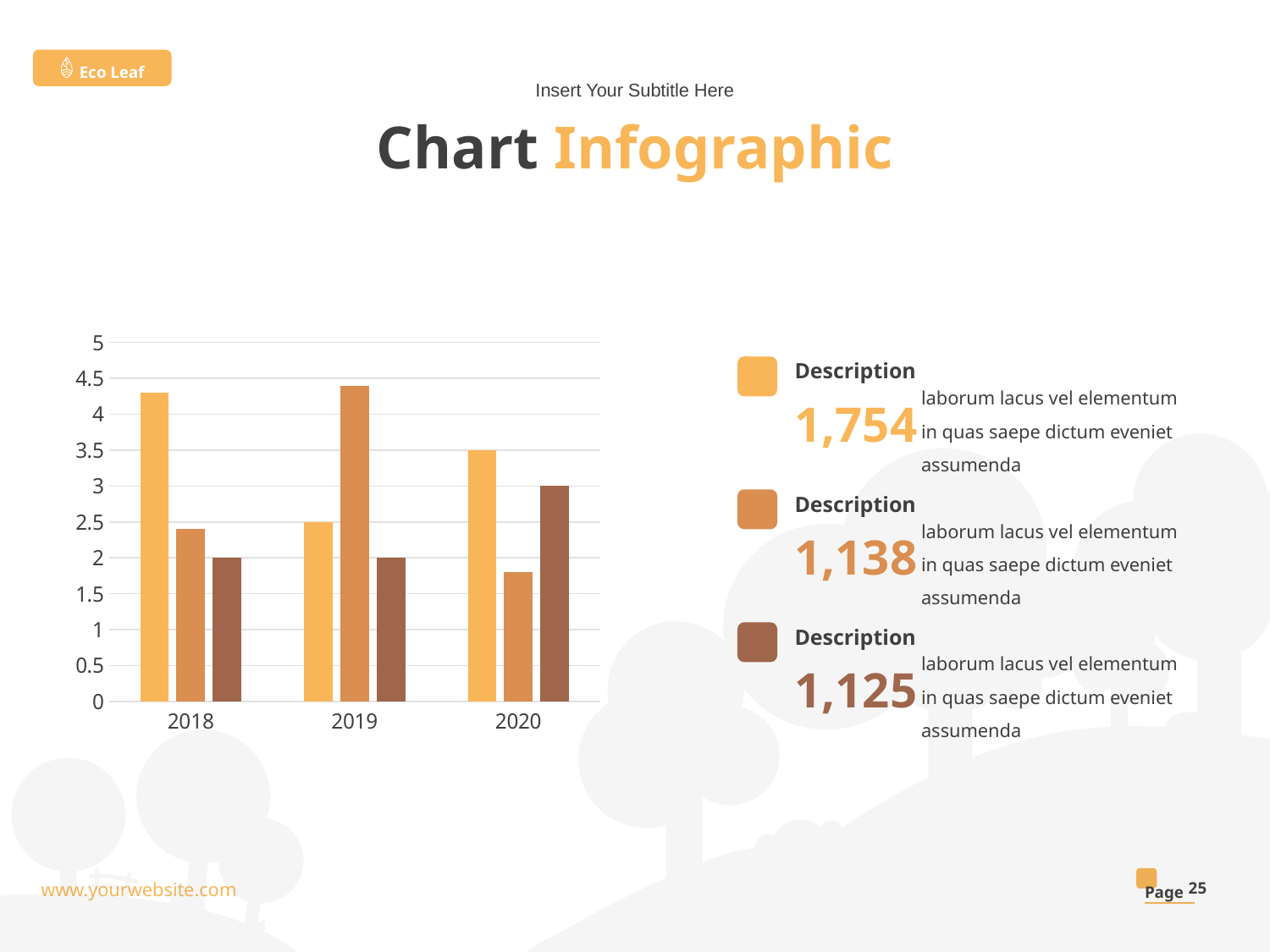
How many categories are shown on the x axis of the chart? 3 Which bar is the shortest for 2020: the light orange, medium orange or brown bar? medium orange What kind of chart is shown on the slide? bar chart Is the value of the medium orange bar for 2019 greater or less than 4? greater Which bar is the tallest for 2019: the light orange, medium orange or brown bar? medium orange Is the value of the light orange bar for 2020 greater or less than 3? greater Is the value of the medium orange bar for 2020 greater or less than 2? less What is the highest value shown on the y axis of the chart? 5 For 2018, which is larger: the light orange bar or the brown bar? light orange How many bars are plotted for each year in the chart? 3 Which year is the first category on the x axis of the chart? 2018